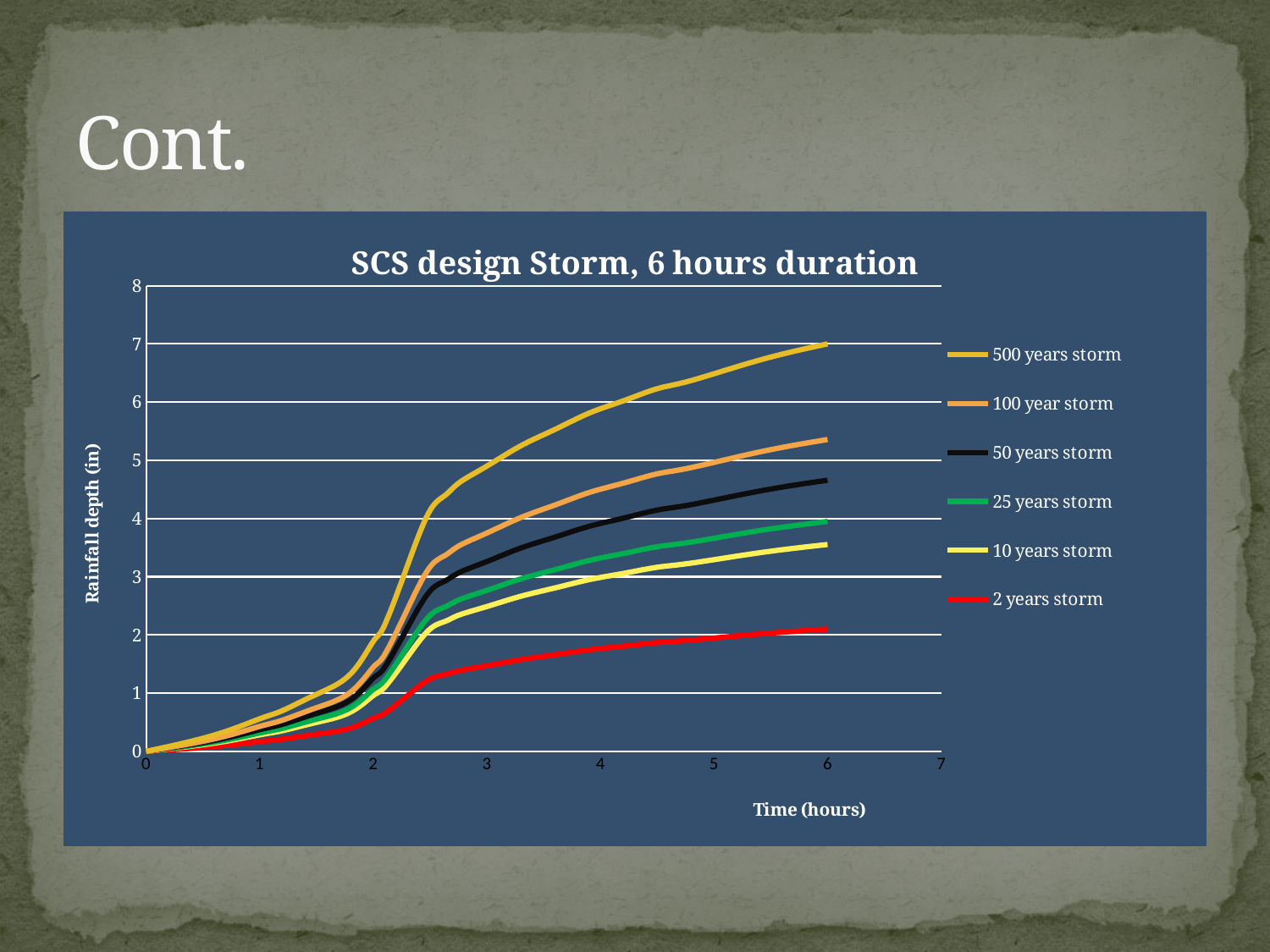
Is the rainfall depth for the 500 years storm at 3 hours greater or less than 4? greater What is the label of the x axis? Time (hours) Which storm series has the lowest rainfall depth at 6 hours? 2 years storm What kind of chart is shown on the slide? line chart How many series does the legend list? 6 Is the rainfall depth for the 50 years storm at 6 hours greater or less than 5? less At 6 hours, which has the larger rainfall depth: the 25 years storm or the 10 years storm? 25 years storm Is the rainfall depth for the 2 years storm at 6 hours greater or less than 3? less Which storm series has the highest rainfall depth at 6 hours? 500 years storm What is the title of the chart? SCS design Storm, 6 hours duration Do the rainfall depth values rise or fall as time increases along the x axis? rise